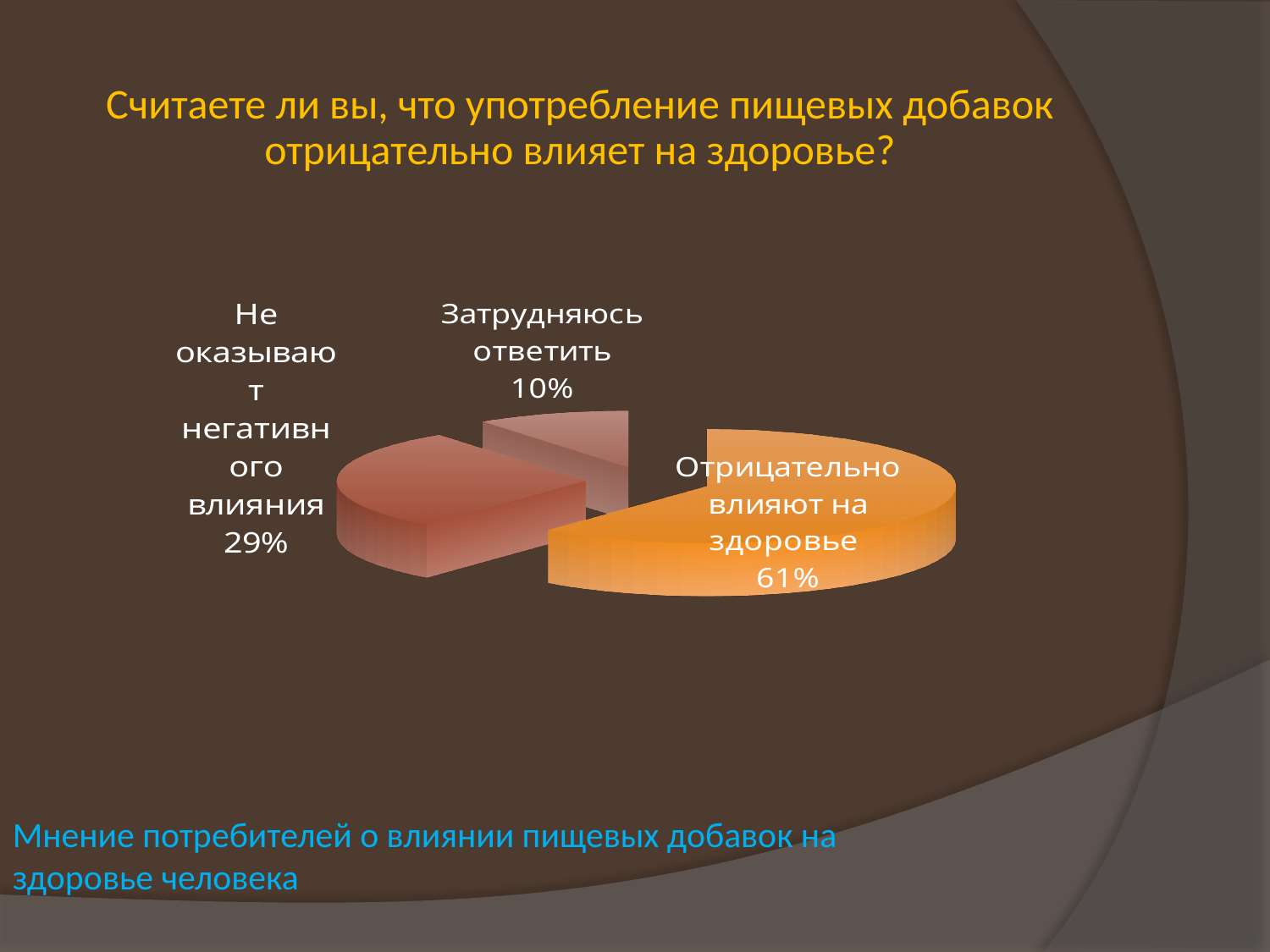
What share of respondents answered "Не оказывают негативного влияния"? 29% What is the difference in percentage points between "Отрицательно влияют на здоровье" and "Не оказывают негативного влияния"? 32 Which answer has the largest share of the pie? Отрицательно влияют на здоровье What share of respondents answered "Отрицательно влияют на здоровье"? 61% What kind of chart is shown on the slide? Pie chart Which is larger: the share for "Не оказывают негативного влияния" or for "Затрудняюсь ответить"? Не оказывают негативного влияния How many slices does the pie chart have? 3 What colour is the slice for "Отрицательно влияют на здоровье"? Orange What share of respondents answered "Затрудняюсь ответить"? 10% What question is posed in the title above the chart? Считаете ли вы, что употребление пищевых добавок отрицательно влияет на здоровье? Which answer has the smallest share of the pie? Затрудняюсь ответить What is the combined share of "Не оказывают негативного влияния" and "Затрудняюсь ответить"? 39%